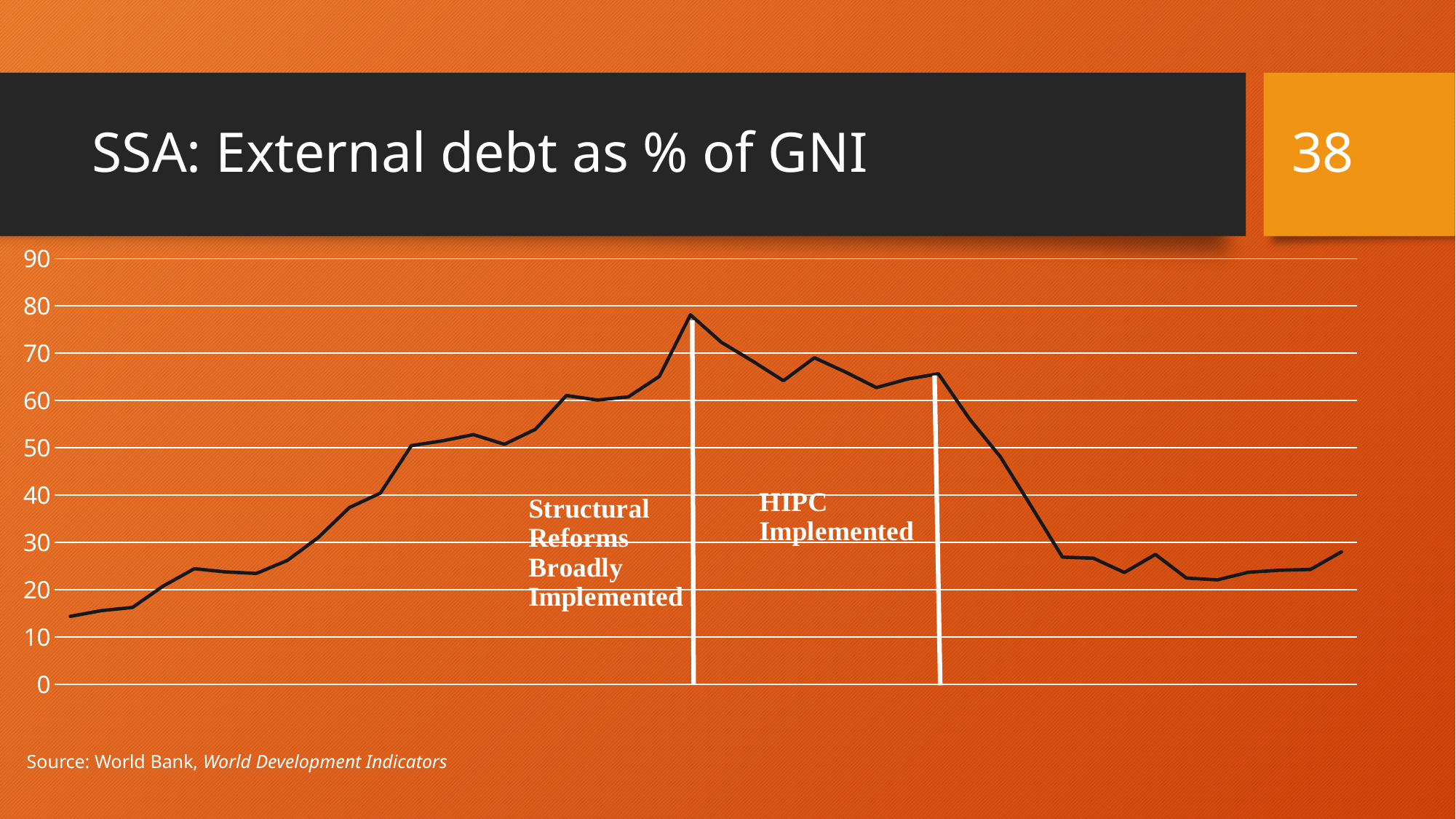
What is the title of the chart on the slide? SSA: External debt as % of GNI What kind of chart is shown on the slide? line chart Is the first (leftmost) value of the line greater or less than 20? less Is the value at the second vertical marker line (labelled HIPC Implemented) greater or less than 60? greater Is the last (rightmost) value of the line greater or less than 40? less Does the line rise or fall immediately after the second vertical marker line (HIPC Implemented)? fall Is the peak of the line located at the first vertical marker line or the second? the first What is the highest value shown on the y axis? 90 Does the line rise or fall between the start of the chart and the first vertical marker line? rise How many lines (data series) are plotted on the chart? 1